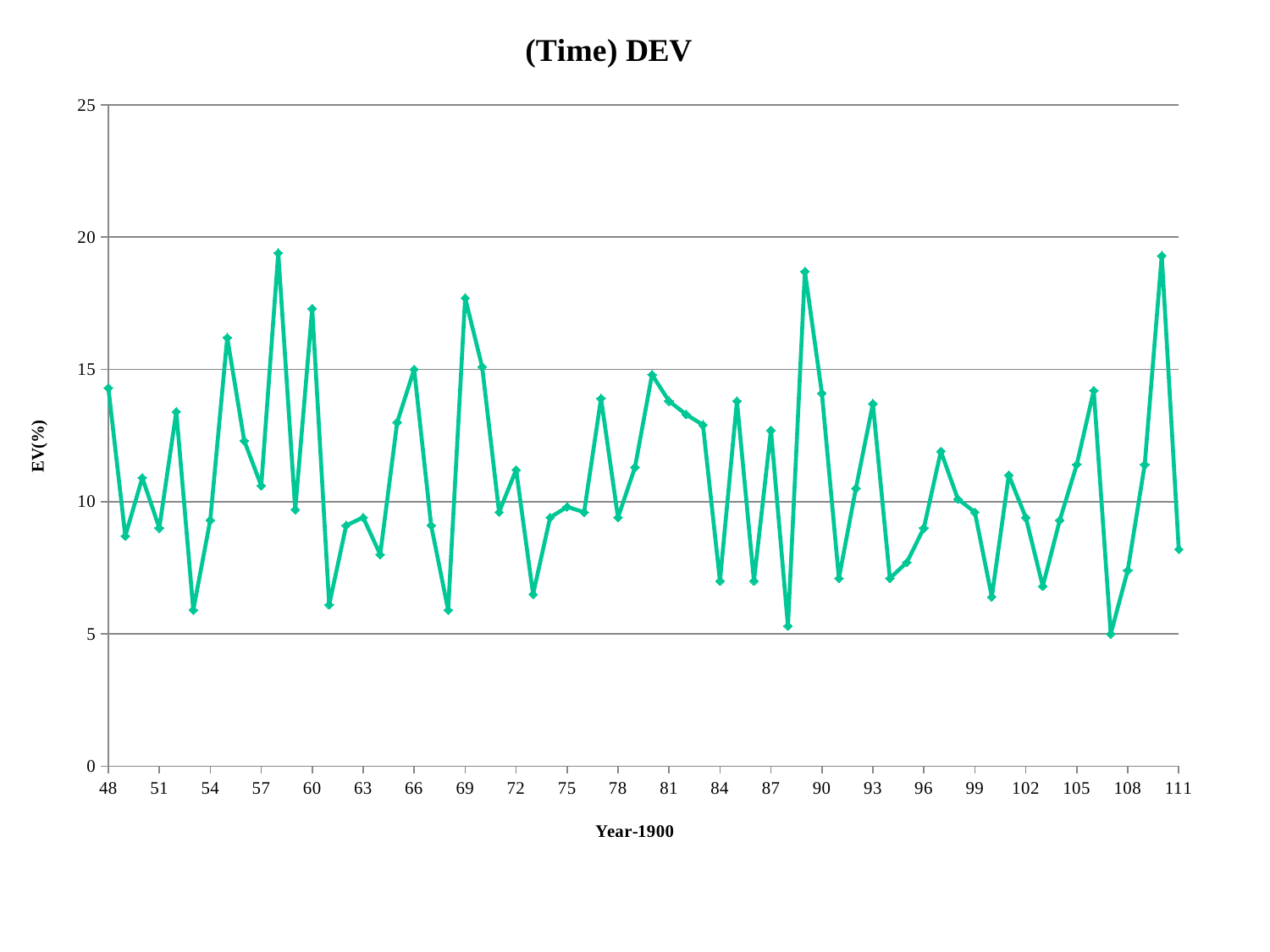
Which has the higher value, year 58 or year 107? 58 Is the value for year 107 greater or less than 10? less What kind of chart is shown on the slide? line chart Is the value for year 100 greater or less than 10? less Is the value for year 53 greater or less than 10? less What is the title of the chart? (Time) DEV What is the label of the x axis? Year-1900 Which has the higher value, year 89 or year 91? 89